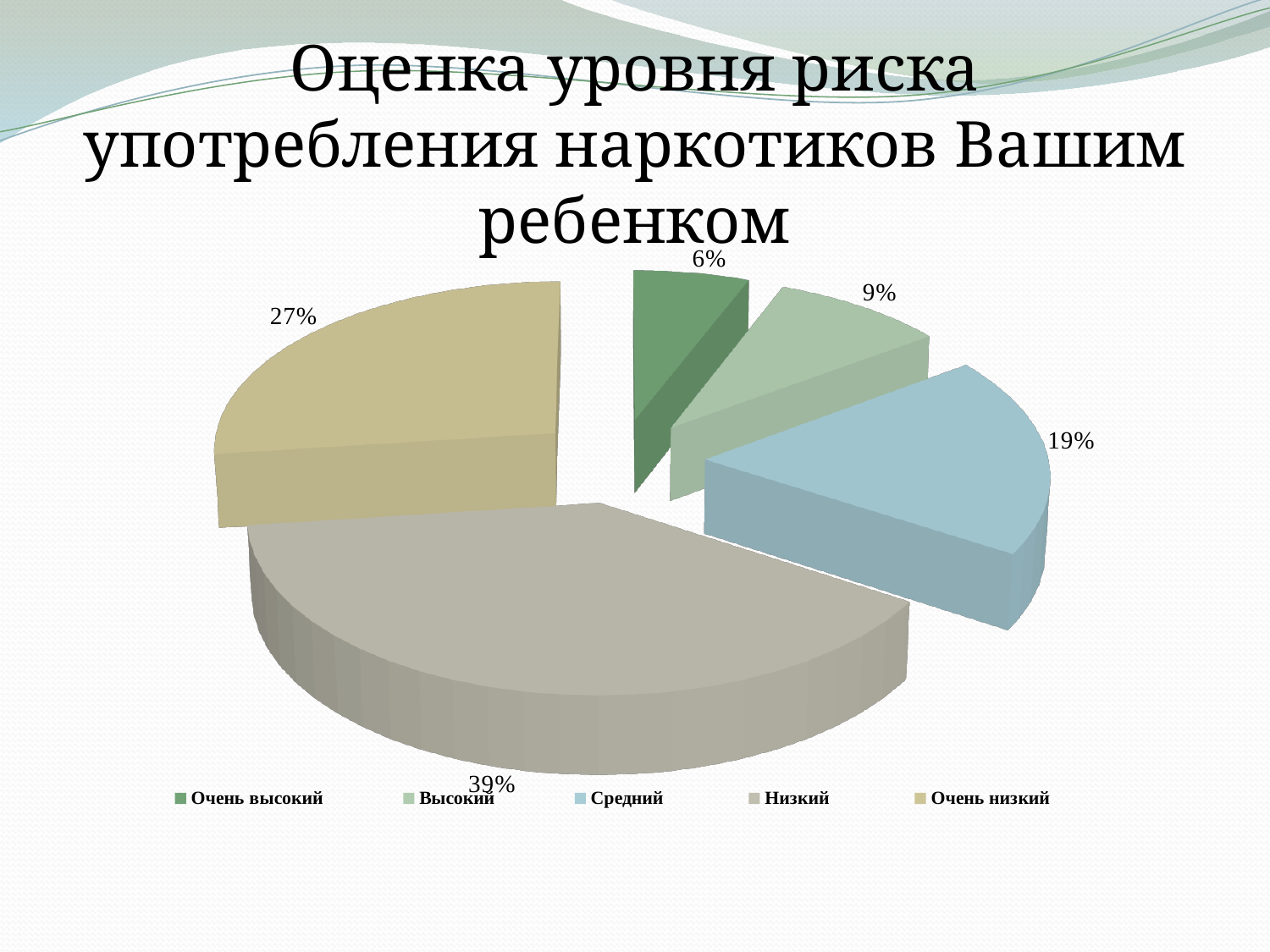
What is the title of the chart on the slide? Оценка уровня риска употребления наркотиков Вашим ребенком What kind of chart is shown on the slide? Pie chart What percentage is shown for the "Средний" slice? 19% How many slices does the pie chart have? 5 How many entries does the legend list? 5 Which category has the largest share of the pie? Низкий What percentage is shown for the "Очень низкий" slice? 27% What percentage is shown for the "Низкий" slice? 39% Which is larger, the "Высокий" share or the "Средний" share? Средний What percentage is shown for the "Очень высокий" slice? 6% What is the difference between the "Низкий" and "Очень низкий" shares? 12% Which category has the smallest share of the pie? Очень высокий